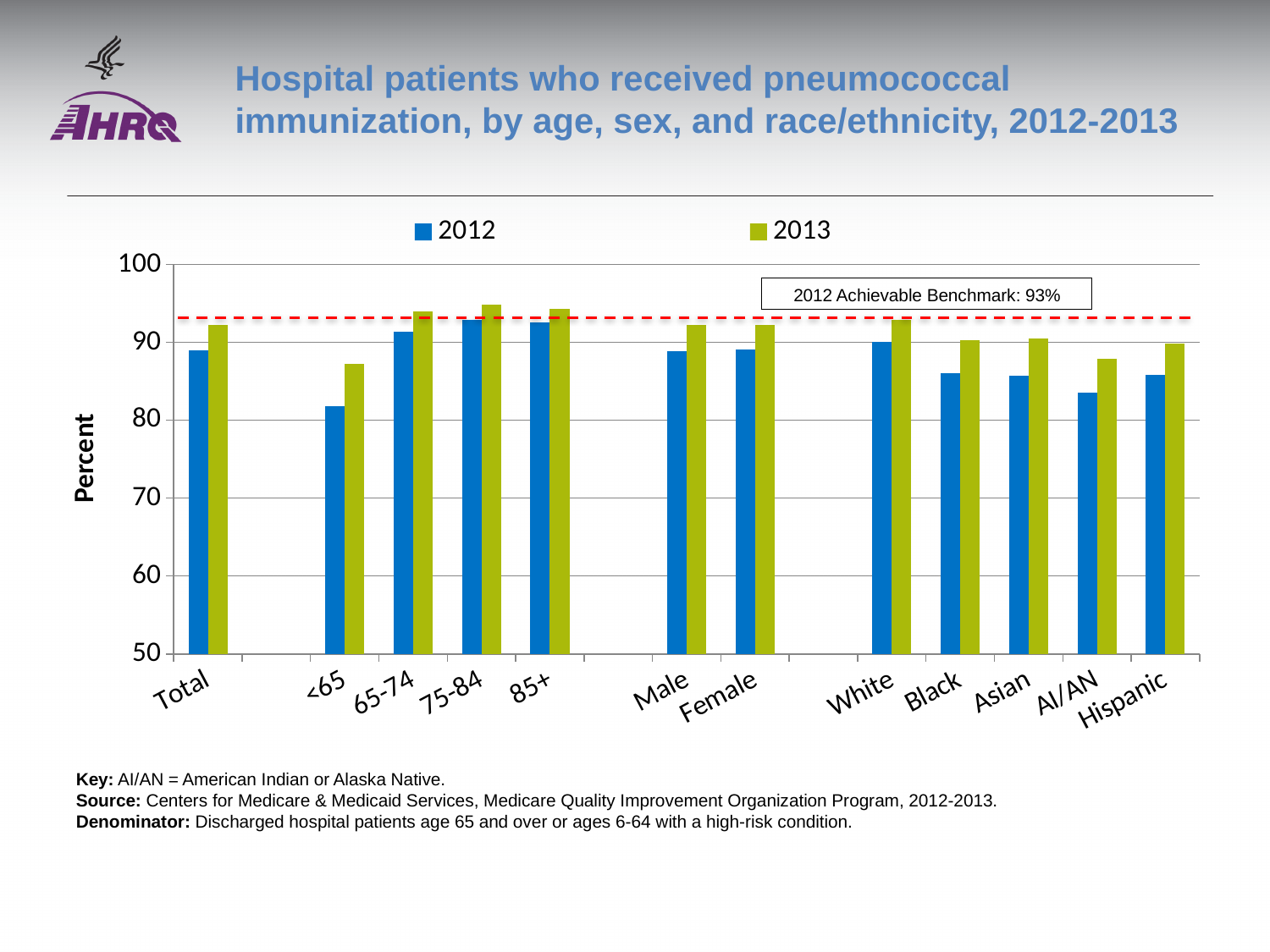
Is the 2012 value for AI/AN greater or less than 90? less For the Total category, which year has the larger value, 2012 or 2013? 2013 For the Black category, which year has the larger value, 2012 or 2013? 2013 What is the label of the y axis? Percent What is the 2012 achievable benchmark shown on the chart? 93% Is the 2013 value for 75-84 greater or less than 90? greater Is the 2012 value for <65 greater or less than 90? less What kind of chart is shown on the slide? bar chart How many series does the legend list? 2 Which is larger for 2012: the value for <65 or the value for 75-84? 75-84 How many categories are shown along the x axis? 12